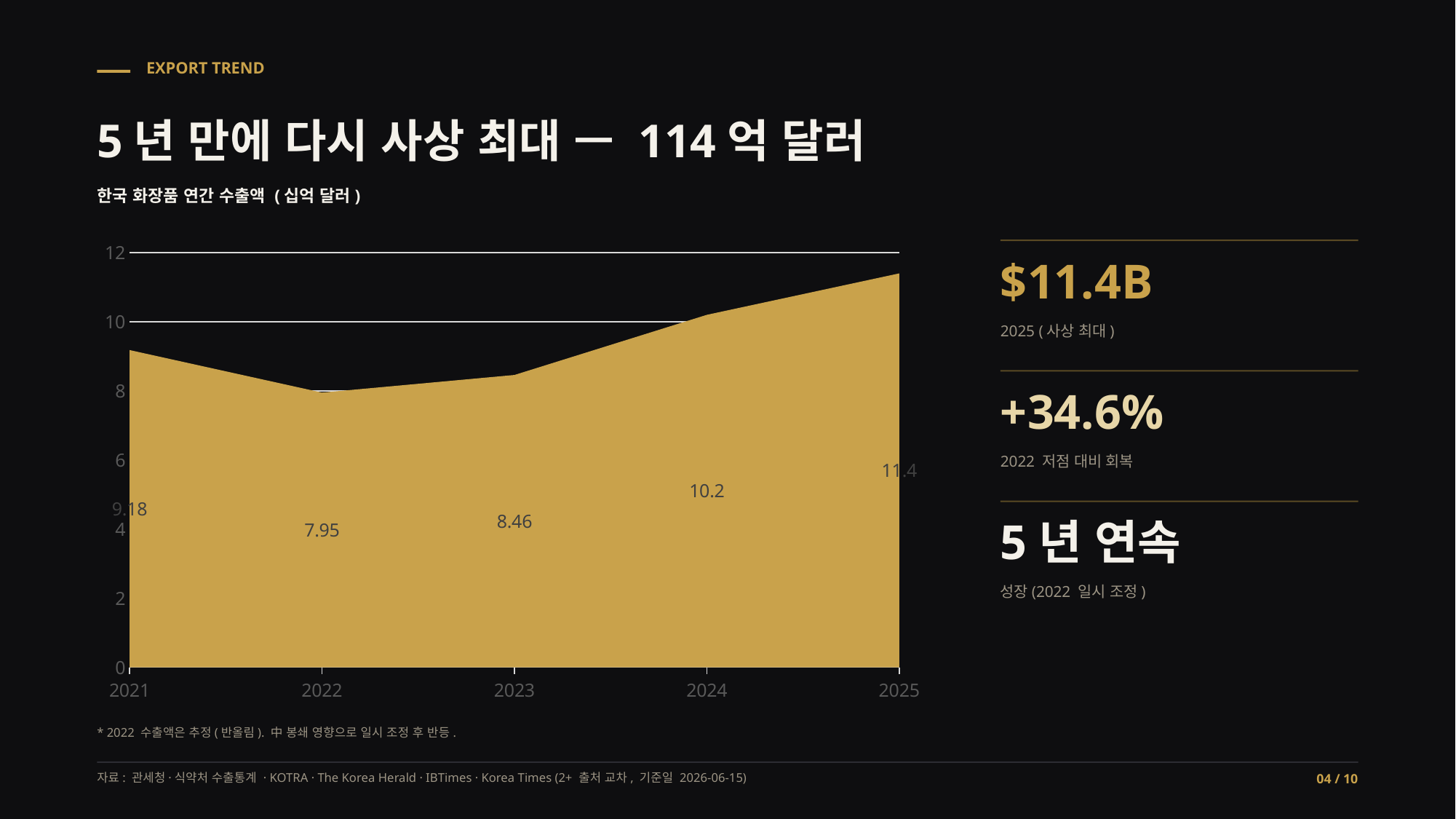
What is the export value for 2024? 10.2 Is the value for 2023 greater or less than 10? less Which year has the lowest export value? 2022 Which year has the highest export value? 2025 What is the export value for 2022? 7.95 Do the values rise or fall from 2022 to 2025? rise What is the export value for 2021? 9.18 How many years are plotted on the x axis? 5 What is the difference between the 2025 value and the 2022 value? 3.45 What is the difference between the 2024 value and the 2023 value? 1.74 Which is larger, the value for 2021 or the value for 2023? 2021 What kind of chart is shown on the slide? Area chart